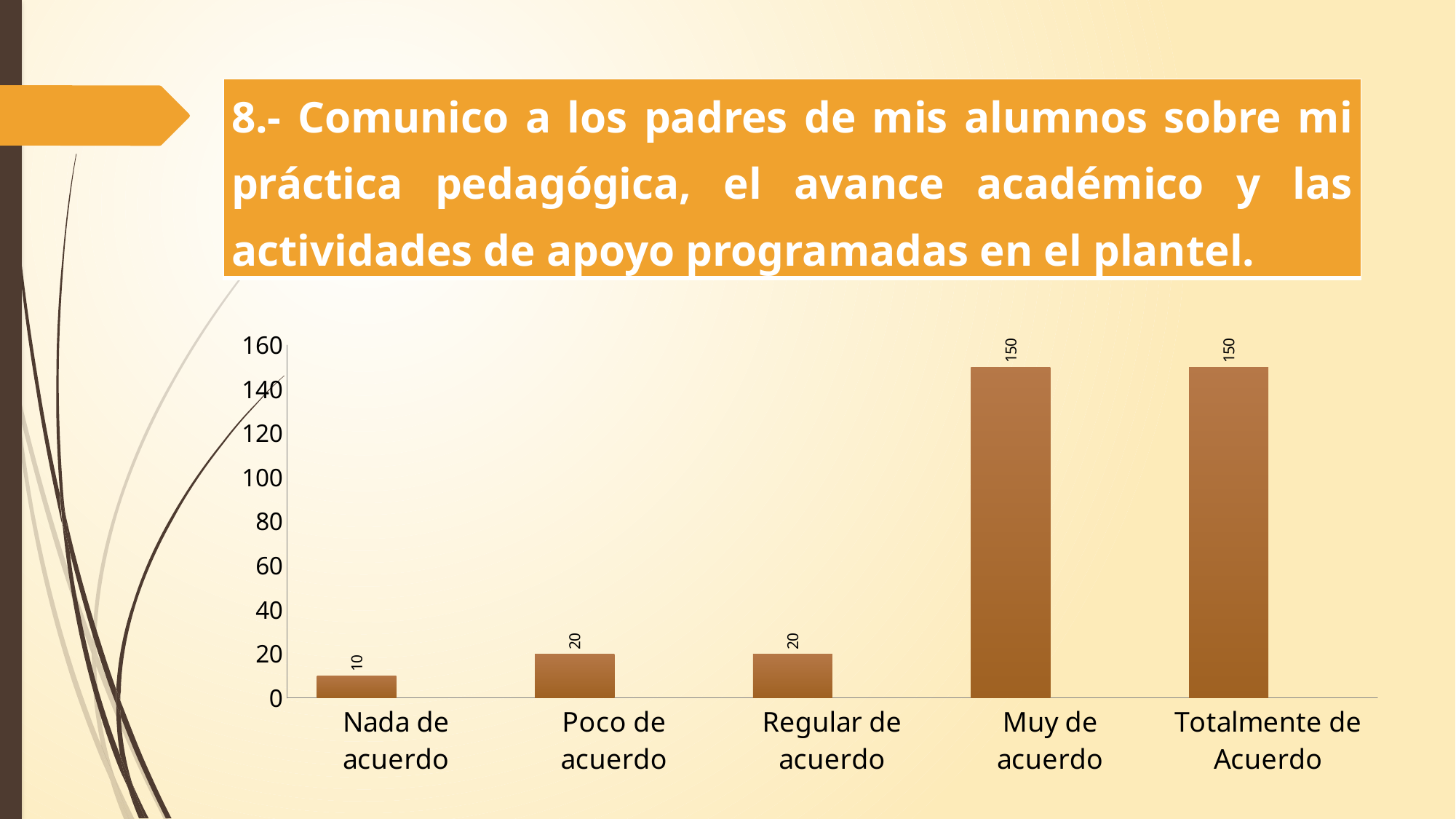
How many categories are shown on the x axis? 5 What is the value for "Muy de acuerdo"? 150 What is the difference between the values for "Poco de acuerdo" and "Nada de acuerdo"? 10 Which is larger, the value for "Totalmente de Acuerdo" or the value for "Nada de acuerdo"? Totalmente de Acuerdo What is the highest value shown on the vertical axis? 160 What is the value for "Totalmente de Acuerdo"? 150 What is the value for "Nada de acuerdo"? 10 Is the value for "Muy de acuerdo" greater or less than 100? greater What is the difference between the values for "Muy de acuerdo" and "Regular de acuerdo"? 130 Which category has the lowest value? Nada de acuerdo What kind of chart is shown on the slide? Bar chart What is the value for "Poco de acuerdo"? 20